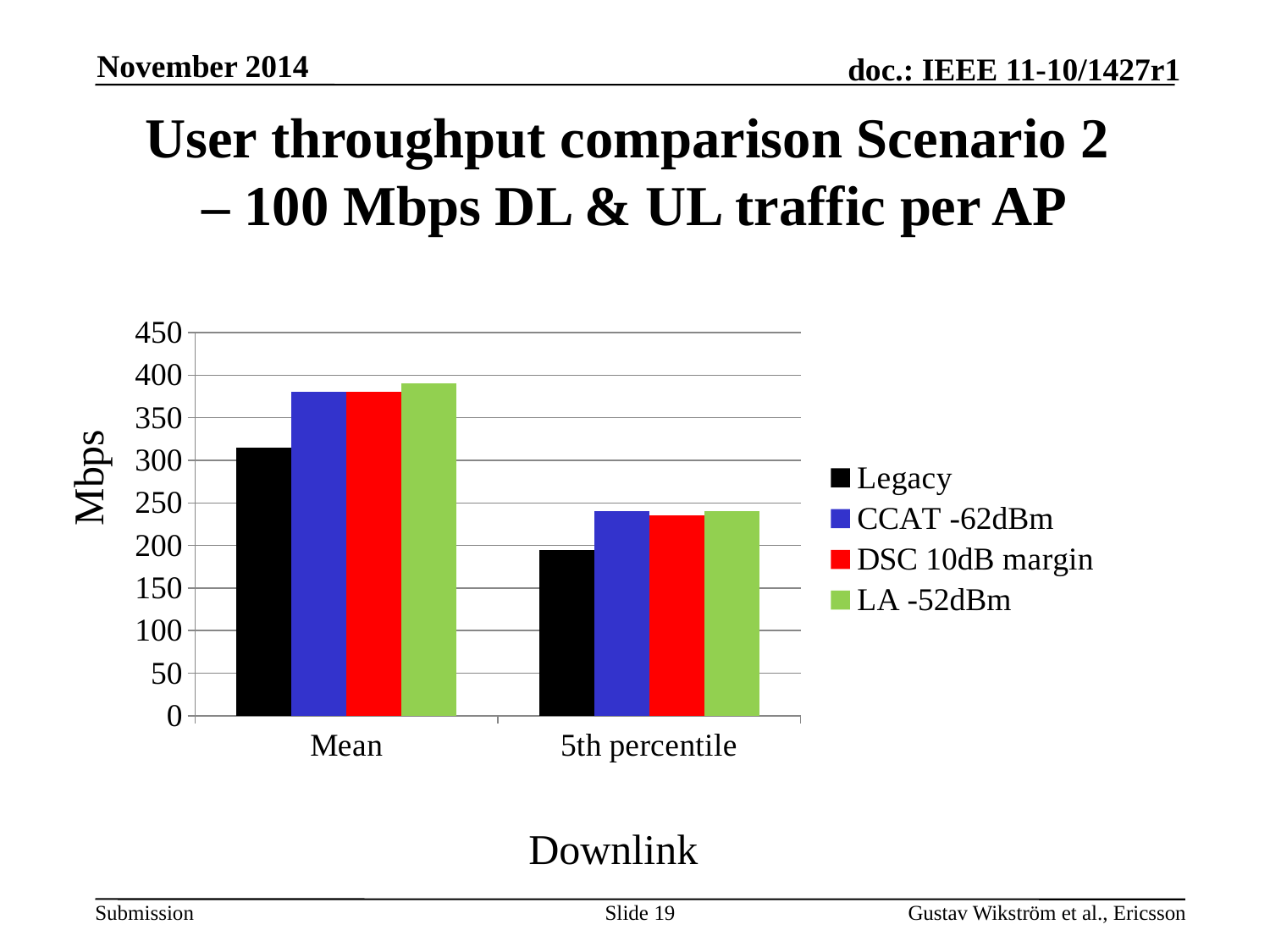
Is the value for CCAT -62dBm in the 5th percentile category greater or less than 200? greater Is the value for LA -52dBm in the Mean category greater or less than 350? greater Which is larger in the Mean category: Legacy or CCAT -62dBm? CCAT -62dBm How many categories are shown on the x axis of the chart? 2 What is the label shown below the x axis of the chart? Downlink Which series has the lowest value in the 5th percentile category? Legacy Is the value for Legacy in the Mean category greater or less than 350? less What is the label on the vertical axis of the chart? Mbps How many series does the chart legend list? 4 What kind of chart is shown on the slide? bar chart Which series has the lowest value in the Mean category? Legacy